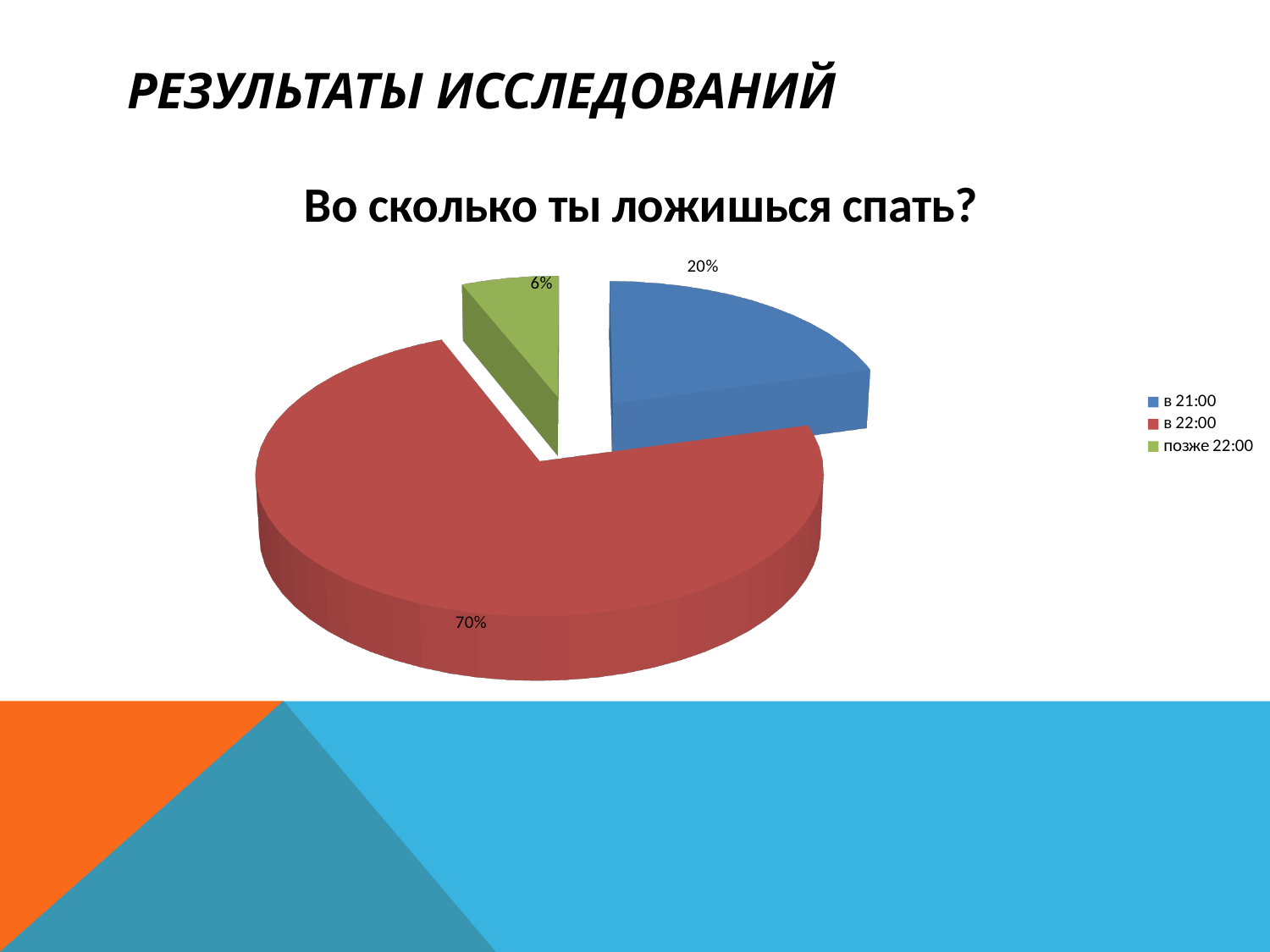
What percentage of respondents go to bed в 21:00? 20% How many categories does the legend list? 3 What is the title of the chart? Во сколько ты ложишься спать? Which is larger: the share for в 21:00 or the share for позже 22:00? в 21:00 Which category has the smallest share of the pie? позже 22:00 What type of chart is shown on the slide? pie chart What is the difference in percentage points between в 21:00 and позже 22:00? 14 What colour is the slice for в 22:00? red What is the difference in percentage points between в 22:00 and в 21:00? 50 What percentage of respondents go to bed позже 22:00? 6% Which category has the largest share of the pie? в 22:00 What percentage of respondents go to bed в 22:00? 70%